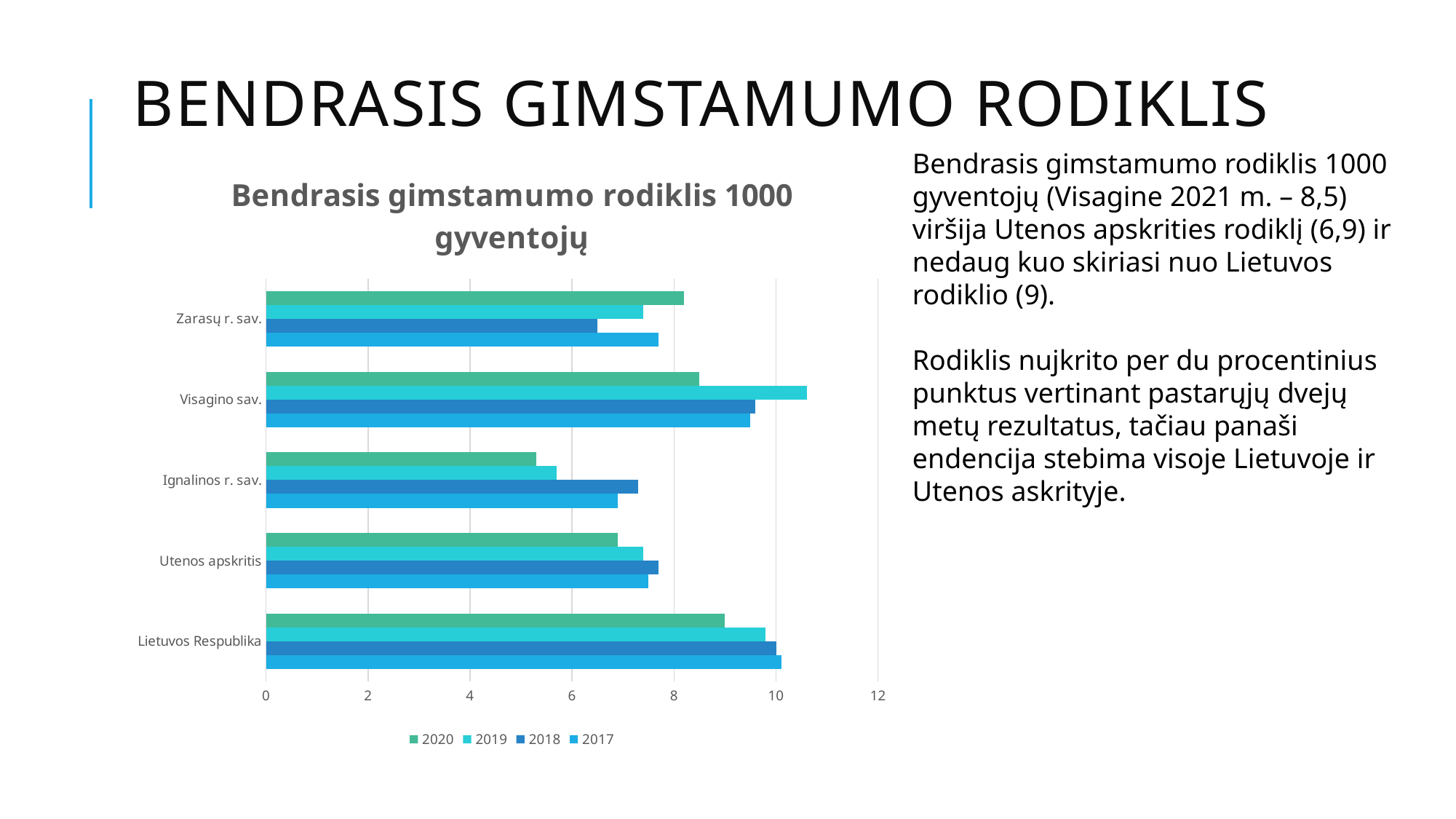
What is the title of the chart? Bendrasis gimstamumo rodiklis 1000 gyventojų How many categories are shown on the chart's vertical axis? 5 Which category has the highest 2019 value? Visagino sav. Which category has the lowest 2020 value? Ignalinos r. sav. Is the 2019 value for Visagino sav. greater or less than 10? greater Is the 2020 value for Lietuvos Respublika greater or less than 8? greater How many series does the chart legend list? 4 What kind of chart is shown on the slide? bar chart Is the 2020 value for Utenos apskritis greater or less than 8? less Which years are listed in the chart legend? 2020, 2019, 2018, 2017 Which is larger, the 2020 value for Visagino sav. or the 2020 value for Ignalinos r. sav.? Visagino sav.